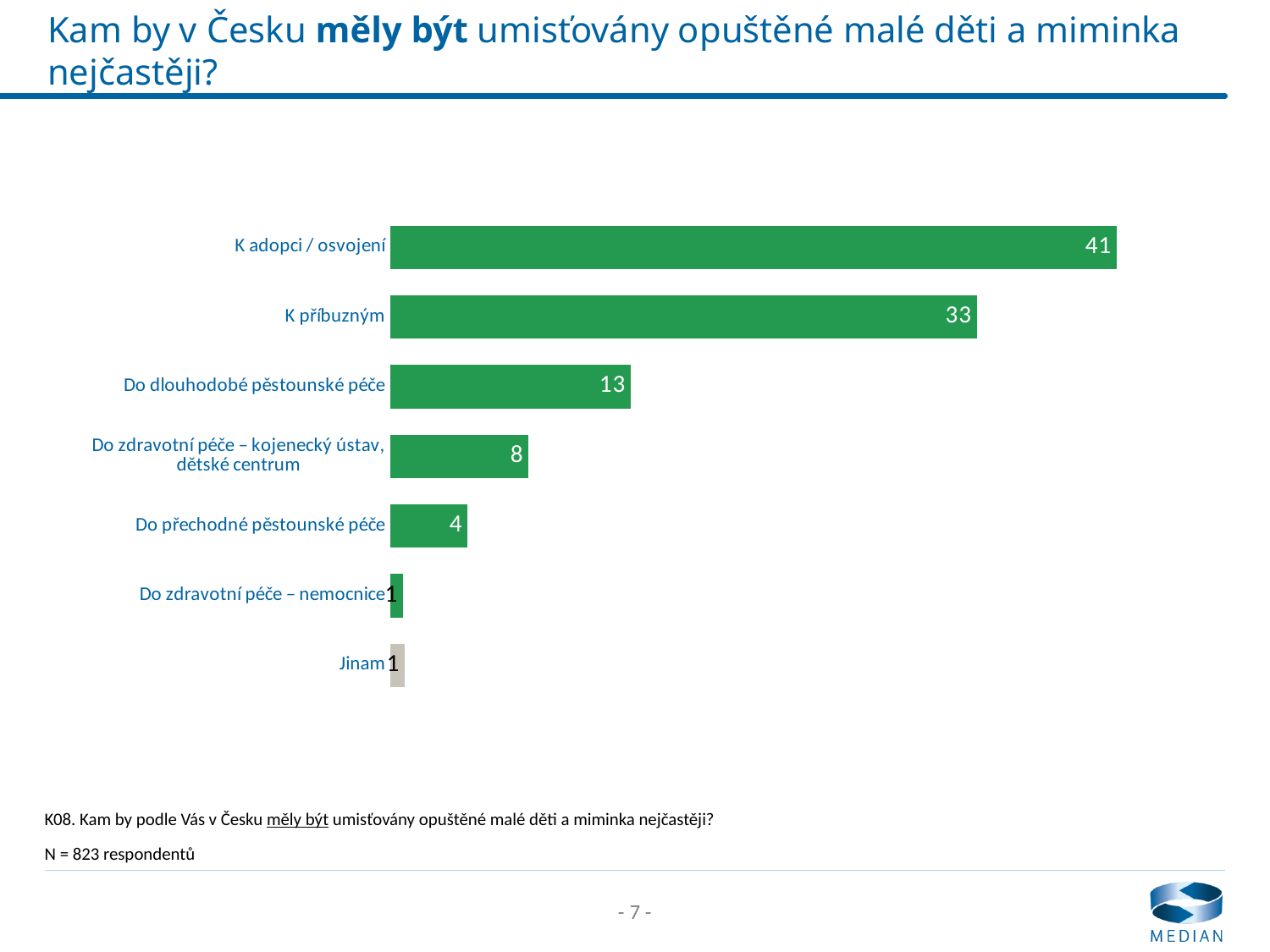
What is the value for "Do zdravotní péče – kojenecký ústav, dětské centrum"? 8 What is the difference between the values for "K adopci / osvojení" and "K příbuzným"? 8 Which is larger: the value for "Do dlouhodobé pěstounské péče" or the value for "Do zdravotní péče – kojenecký ústav, dětské centrum"? Do dlouhodobé pěstounské péče What is the difference between the values for "Do dlouhodobé pěstounské péče" and "Do přechodné pěstounské péče"? 9 Which category has the highest value? K adopci / osvojení How many categories are shown in the chart? 7 What kind of chart is shown on the slide? bar chart What is the value for "K příbuzným"? 33 What is the value for "Do přechodné pěstounské péče"? 4 What is the value for "K adopci / osvojení"? 41 Which bar is shown in a different colour (grey) from the others? Jinam What is the value for "Do dlouhodobé pěstounské péče"? 13